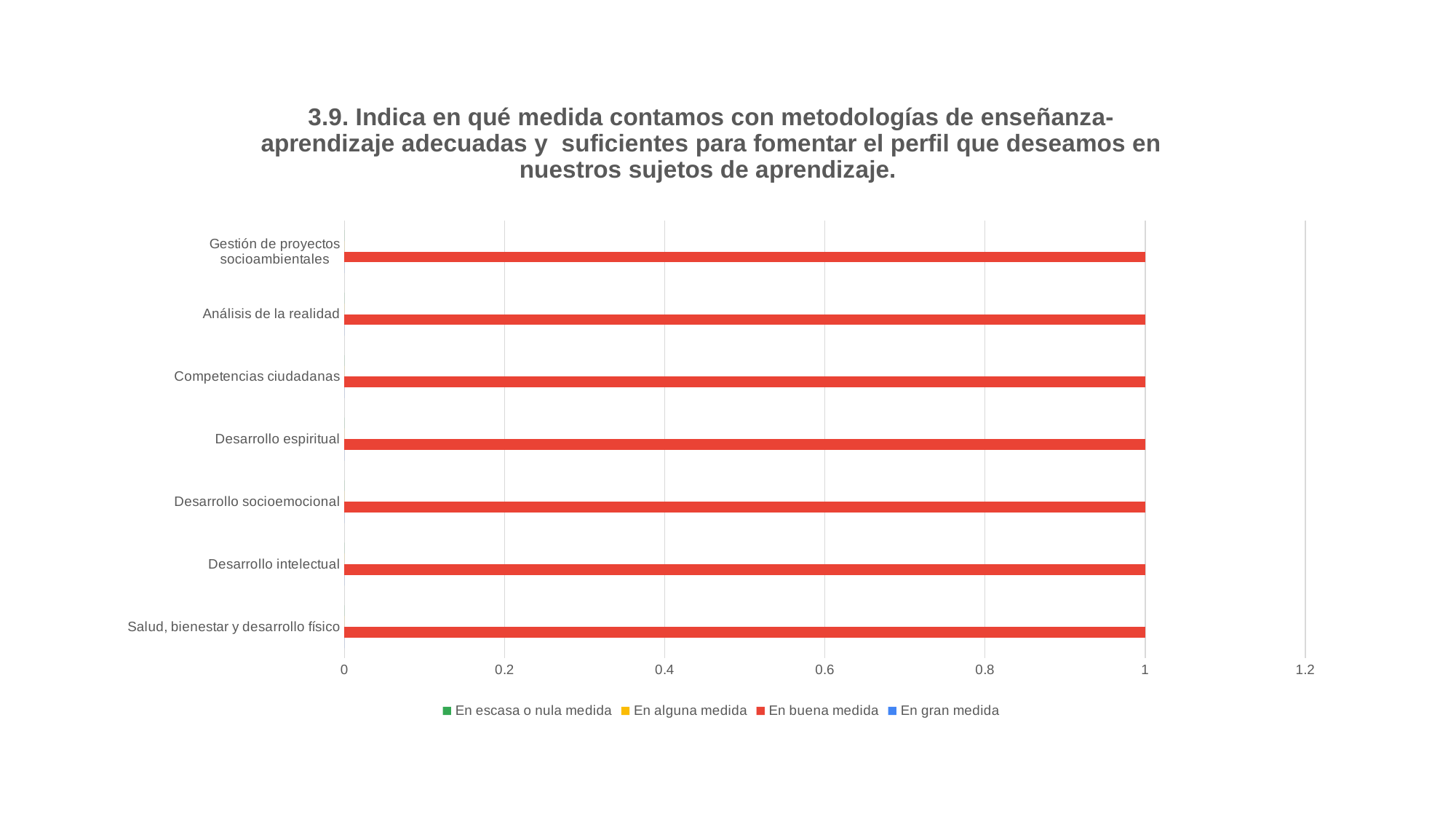
Which series in the legend is shown in red? En buena medida What is the first series listed in the chart's legend? En escasa o nula medida What is the highest value shown on the horizontal axis of the chart? 1.2 What is the value of the 'En buena medida' bar for 'Salud, bienestar y desarrollo físico'? 1 How many series does the chart's legend list? 4 Is the 'En buena medida' value for 'Competencias ciudadanas' greater or less than 0.8? greater Is the 'En buena medida' value for 'Desarrollo espiritual' greater or less than 1.2? less What is the difference between the 'En buena medida' values for 'Gestión de proyectos socioambientales' and 'Desarrollo socioemocional'? 0 What is the value of the 'En buena medida' bar for 'Análisis de la realidad'? 1 How many categories are listed on the vertical axis of the chart? 7 What kind of chart is shown on the slide? bar chart What is the value of the 'En buena medida' bar for 'Desarrollo intelectual'? 1